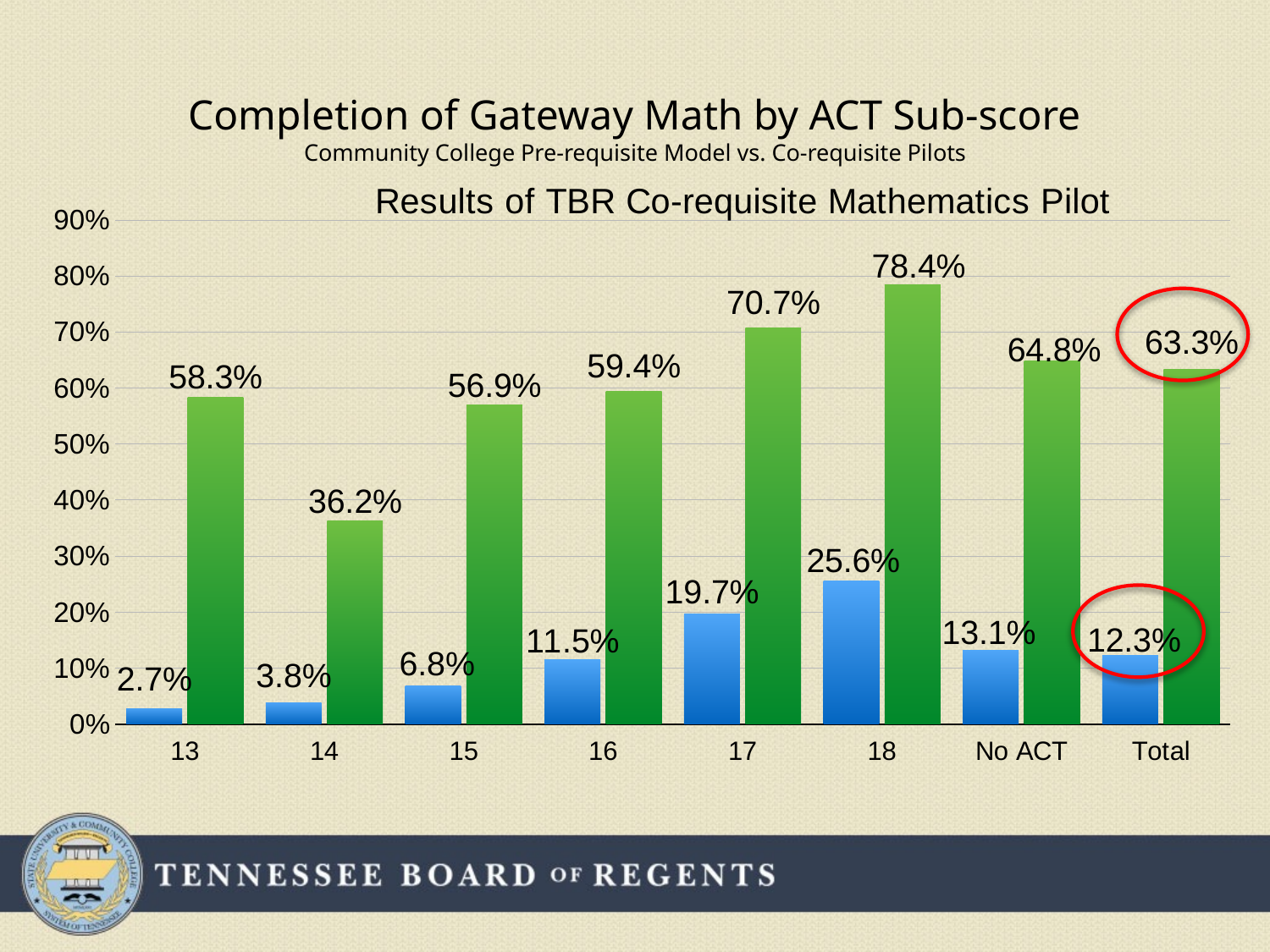
What is the value of the blue bar for the Total category? 12.3% Which category has the highest green bar? 18 What is the value of the green bar for the No ACT category? 64.8% What is the difference between the green bar and the blue bar for the Total category? 51.0% Which category has the lowest blue bar? 13 What kind of chart is shown on the slide? Bar chart Is the blue bar for ACT sub-score 18 greater or less than 20%? greater Which is larger, the green bar for 14 or the green bar for 15? 15 How many categories are shown on the x axis? 8 What is the value of the green bar for ACT sub-score 18? 78.4% What is the value of the blue bar for ACT sub-score 13? 2.7% What is the title shown above the chart's plot area? Results of TBR Co-requisite Mathematics Pilot